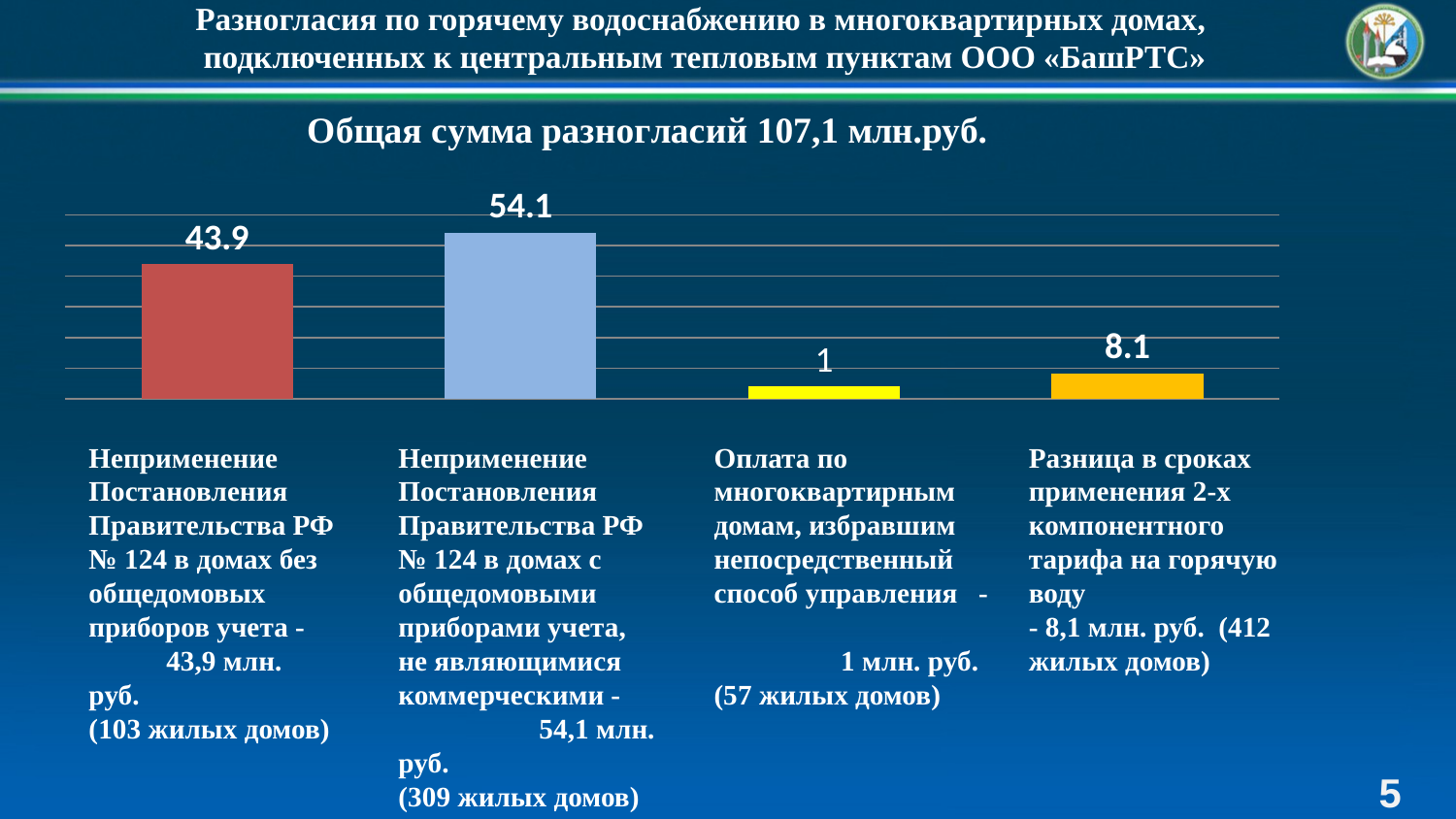
Which bar has the lowest value? Payment by houses with direct management (1) What is the value of the bar for non-application of Government Decree No. 124 in houses with common building meters that are not commercial (second bar)? 54.1 What type of chart is shown on the slide? bar chart What total sum of disagreements is stated above the chart? 107,1 млн.руб. Which is larger: the fourth bar (two-component tariff timing) or the third bar (direct management payment)? the fourth bar (8.1) What is the difference between the fourth bar (8.1) and the third bar (1)? 7.1 Which bar has the highest value? Non-application of Decree No. 124 in houses with common building meters (54.1) What is the difference between the second bar (54.1) and the first bar (43.9)? 10.2 How many bars are plotted in the chart? 4 What is the value of the bar for payment by apartment buildings that chose direct management (third bar)? 1 What is the value of the bar for the difference in timing of applying the two-component hot water tariff (fourth bar)? 8.1 What is the value of the bar for non-application of Government Decree No. 124 in houses without common building meters (first bar)? 43.9